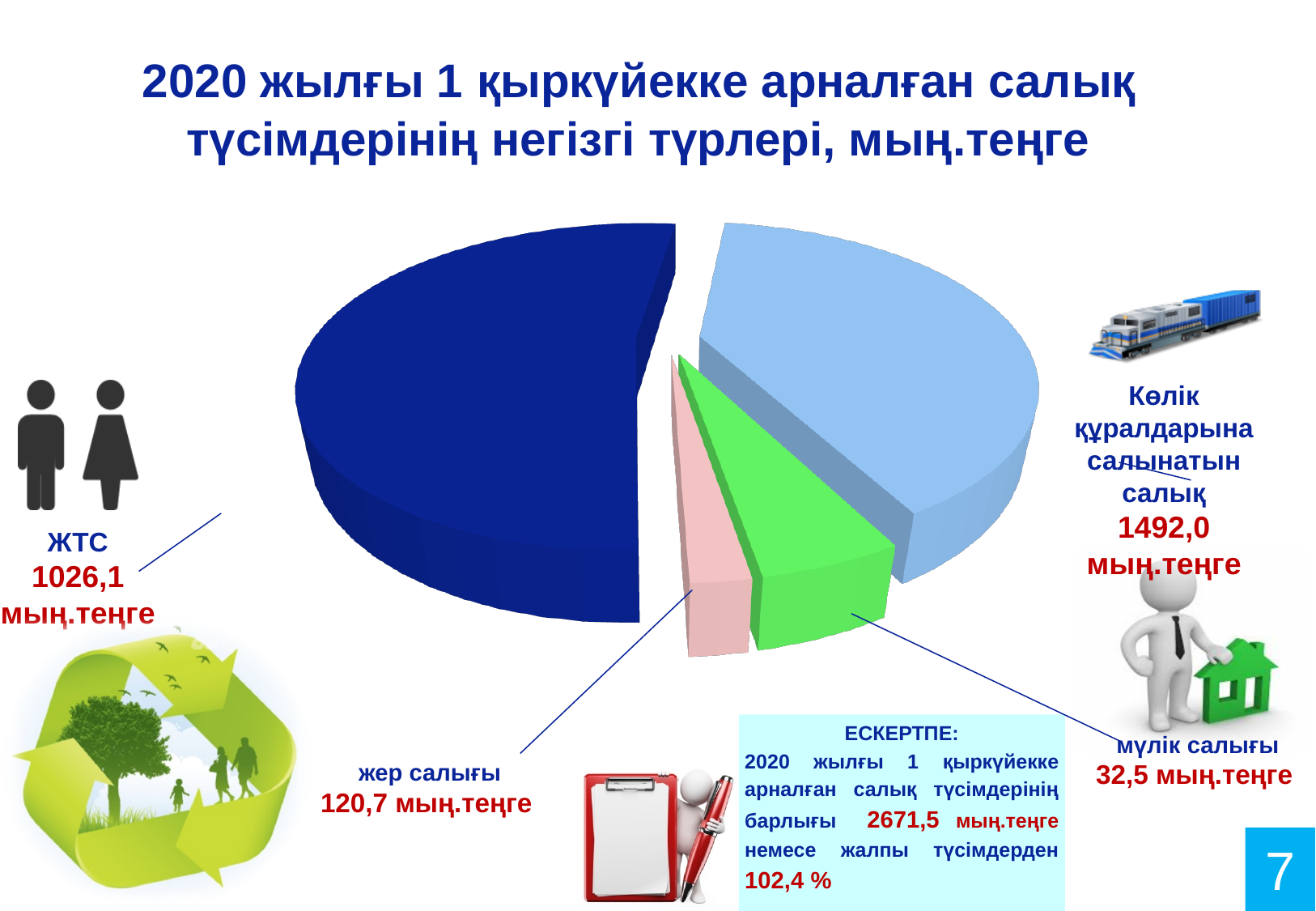
Which category has the highest value? Көлік құралдарына салынатын салық What is the value for мүлік салығы? 32,5 мың.теңге What is the value for Көлік құралдарына салынатын салық? 1492,0 мың.теңге How many categories (slices) does the pie chart show? 4 What is the difference between жер салығы and мүлік салығы? 88,2 мың.теңге Which category has the lowest value? мүлік салығы What is the difference between Көлік құралдарына салынатын салық and ЖТС? 465,9 мың.теңге What is the total of all tax receipts shown on the slide? 2671,5 мың.теңге What is the value for жер салығы? 120,7 мың.теңге Which is larger, ЖТС or жер салығы? ЖТС What type of chart is shown on the slide? pie chart What is the value for ЖТС? 1026,1 мың.теңге